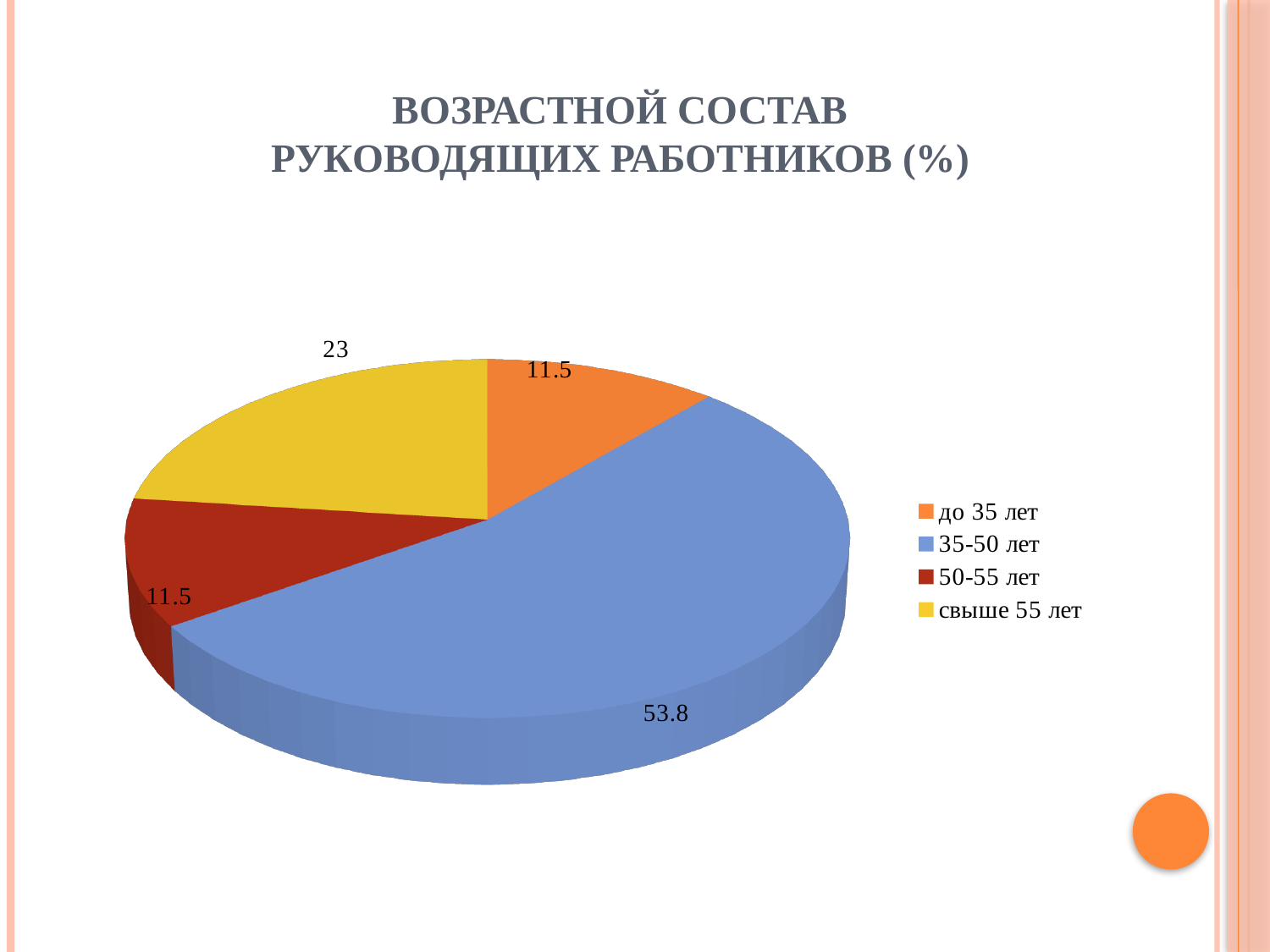
What is the value for the category "35-50 лет"? 53.8 What is the difference between the values for "35-50 лет" and "свыше 55 лет"? 30.8 What is the value for the category "свыше 55 лет"? 23 What is the title of the chart? ВОЗРАСТНОЙ СОСТАВ РУКОВОДЯЩИХ РАБОТНИКОВ (%) What kind of chart is shown on the slide? pie chart What is the difference between the values for "свыше 55 лет" and "до 35 лет"? 11.5 Which colour represents the category "свыше 55 лет" in the legend? yellow Which age category has the largest slice of the pie? 35-50 лет How many categories does the pie chart have? 4 Which is larger, the value for "35-50 лет" or the value for "свыше 55 лет"? 35-50 лет What is the value for the category "50-55 лет"? 11.5 What is the value for the category "до 35 лет"? 11.5